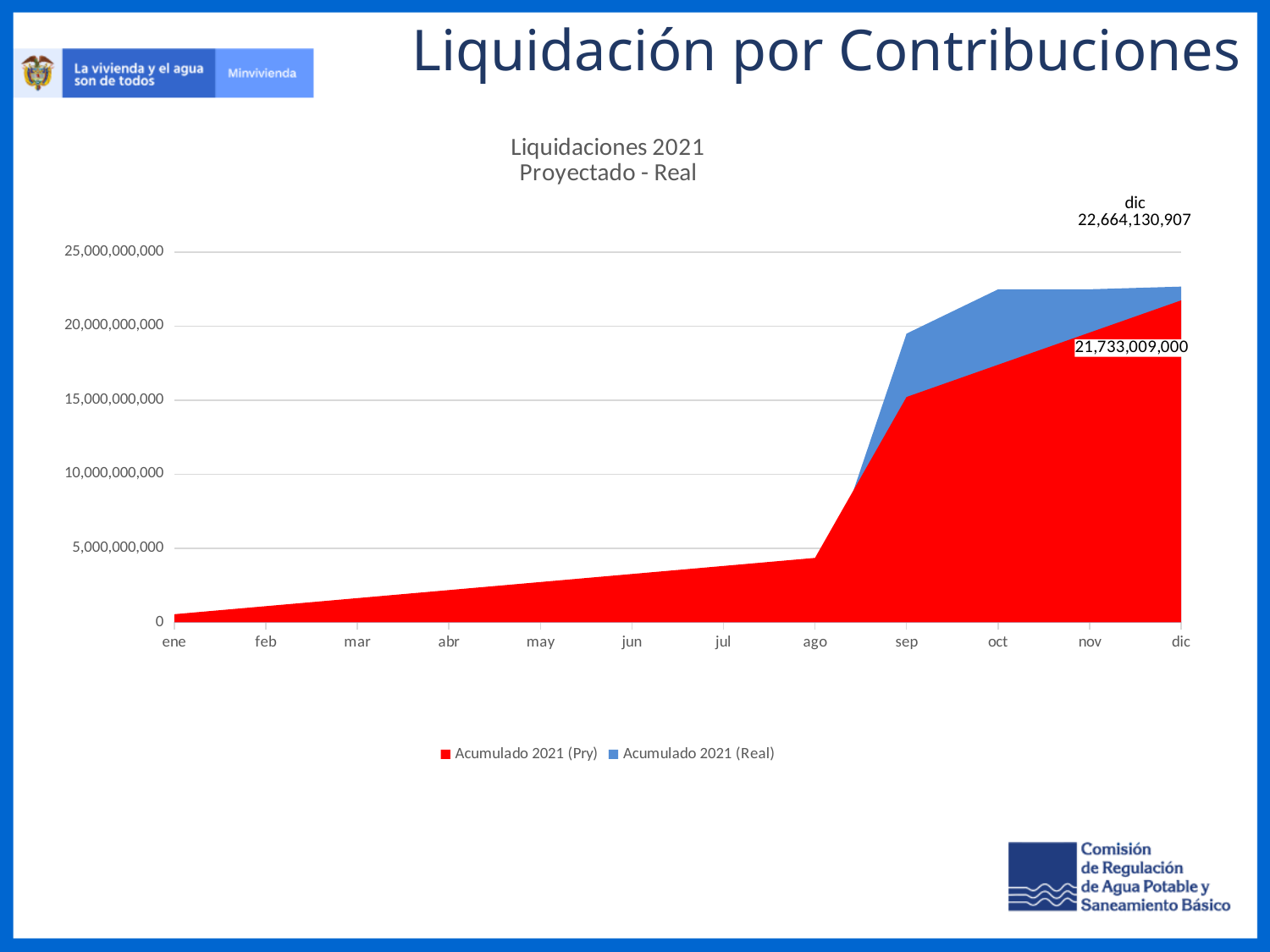
What is the value of Acumulado 2021 (Pry) in dic? 21,733,009,000 What is the title of the chart? Liquidaciones 2021 Proyectado - Real Is the value of Acumulado 2021 (Pry) in ago greater or less than 5,000,000,000? less Do the values of Acumulado 2021 (Pry) rise or fall from ene to dic? rise How many months are shown on the x axis of the chart? 12 What is the difference between Acumulado 2021 (Real) and Acumulado 2021 (Pry) in dic? 931,121,907 What is the value of Acumulado 2021 (Real) in dic? 22,664,130,907 Is the value of Acumulado 2021 (Real) in oct greater or less than 20,000,000,000? greater In dic, which series has the larger value, Acumulado 2021 (Pry) or Acumulado 2021 (Real)? Acumulado 2021 (Real) What kind of chart is shown on the slide? Area chart How many series does the legend of the chart list? 2 In which month does Acumulado 2021 (Pry) reach its highest value? dic